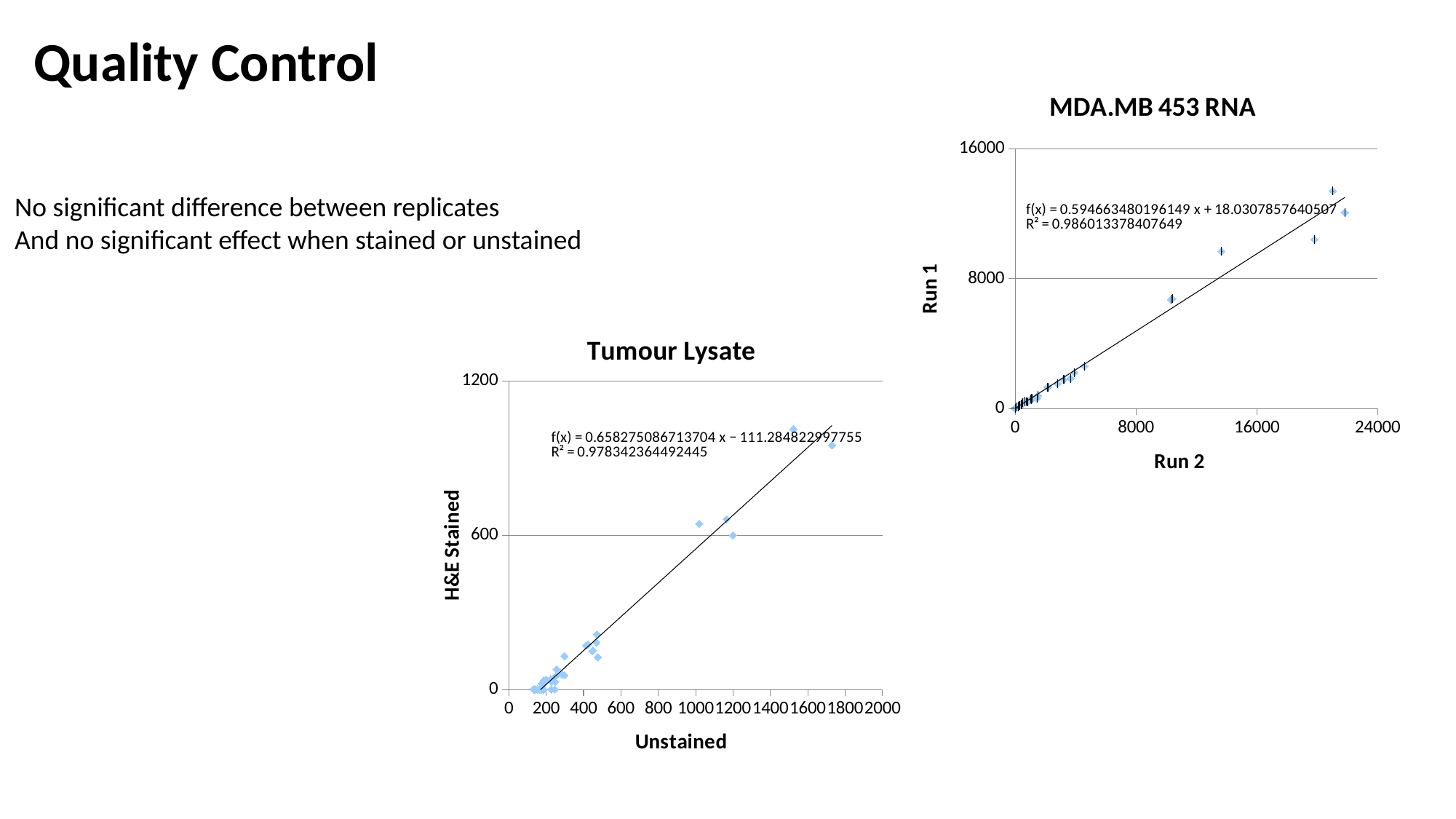
In the Tumour Lysate chart, do the H&E Stained values rise or fall as the Unstained values increase? rise What kind of chart is the MDA.MB 453 RNA chart? scatter chart What is the x-axis label of the Tumour Lysate chart? Unstained What is the fitted equation shown on the Tumour Lysate chart? f(x) = 0.658275086713704 x − 111.284822997755 What is the fitted equation shown on the MDA.MB 453 RNA chart? f(x) = 0.594663480196149 x + 18.0307857640507 In the MDA.MB 453 RNA chart, is the highest Run 1 value greater or less than 8000? greater In the MDA.MB 453 RNA chart, do the Run 1 values rise or fall as the Run 2 values increase? rise In the Tumour Lysate chart, is the highest H&E Stained value greater or less than 600? greater What kind of chart is the Tumour Lysate chart? scatter chart